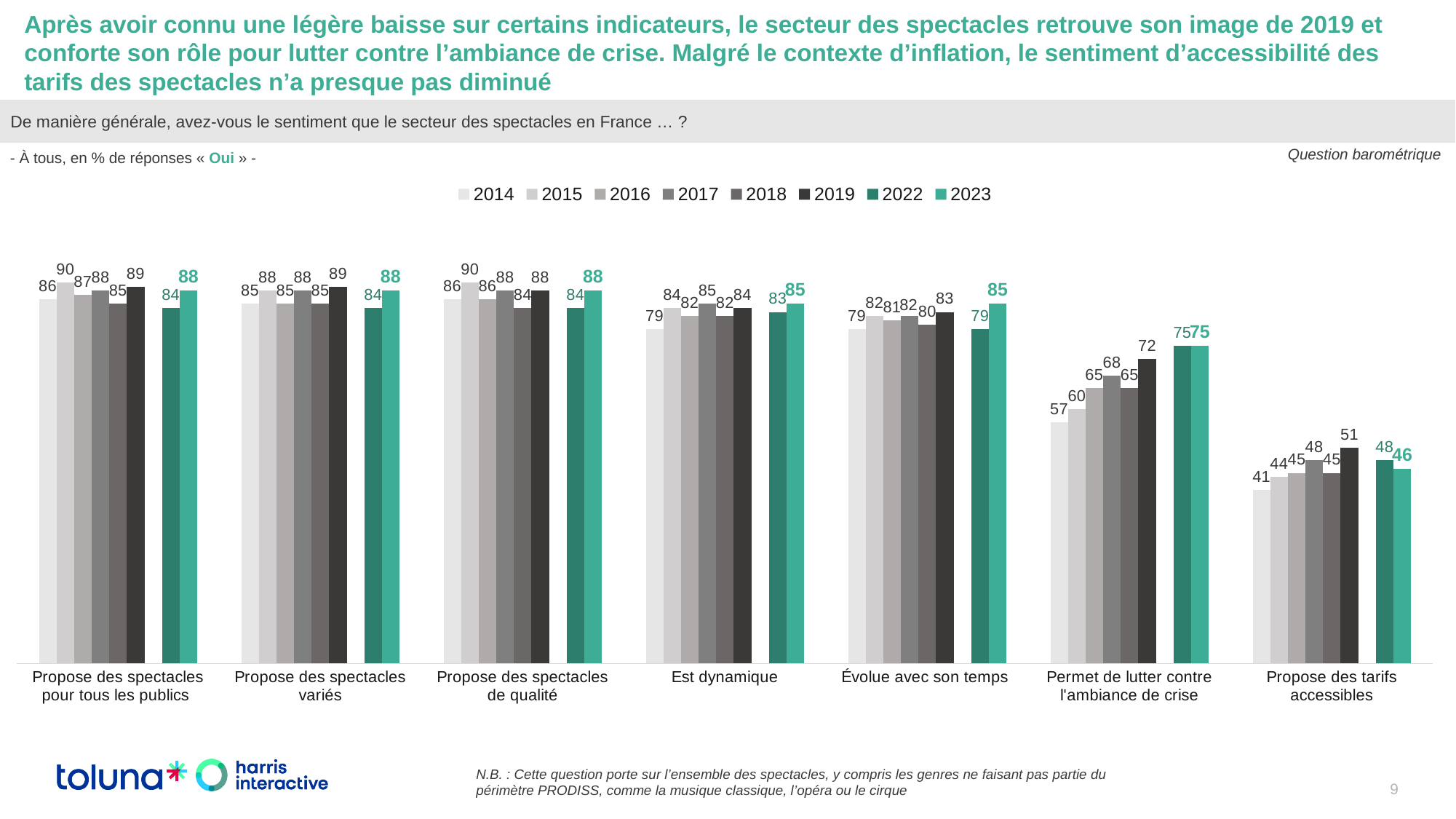
How many categories are shown on the x axis? 7 How many series does the legend list? 8 What is the 2019 value for "Évolue avec son temps"? 83 What is the 2022 value for "Est dynamique"? 83 What is the 2023 value for "Permet de lutter contre l'ambiance de crise"? 75 Which category has the lowest 2023 value? Propose des tarifs accessibles What is the 2014 value for "Propose des tarifs accessibles"? 41 Do the values for "Permet de lutter contre l'ambiance de crise" generally rise or fall from 2014 to 2023? Rise What kind of chart is shown on the slide? Bar chart Which year has the highest value for "Propose des spectacles pour tous les publics"? 2015 Which is larger for "Propose des tarifs accessibles": the 2019 value or the 2023 value? 2019 What is the difference between the 2023 and 2014 values for "Permet de lutter contre l'ambiance de crise"? 18